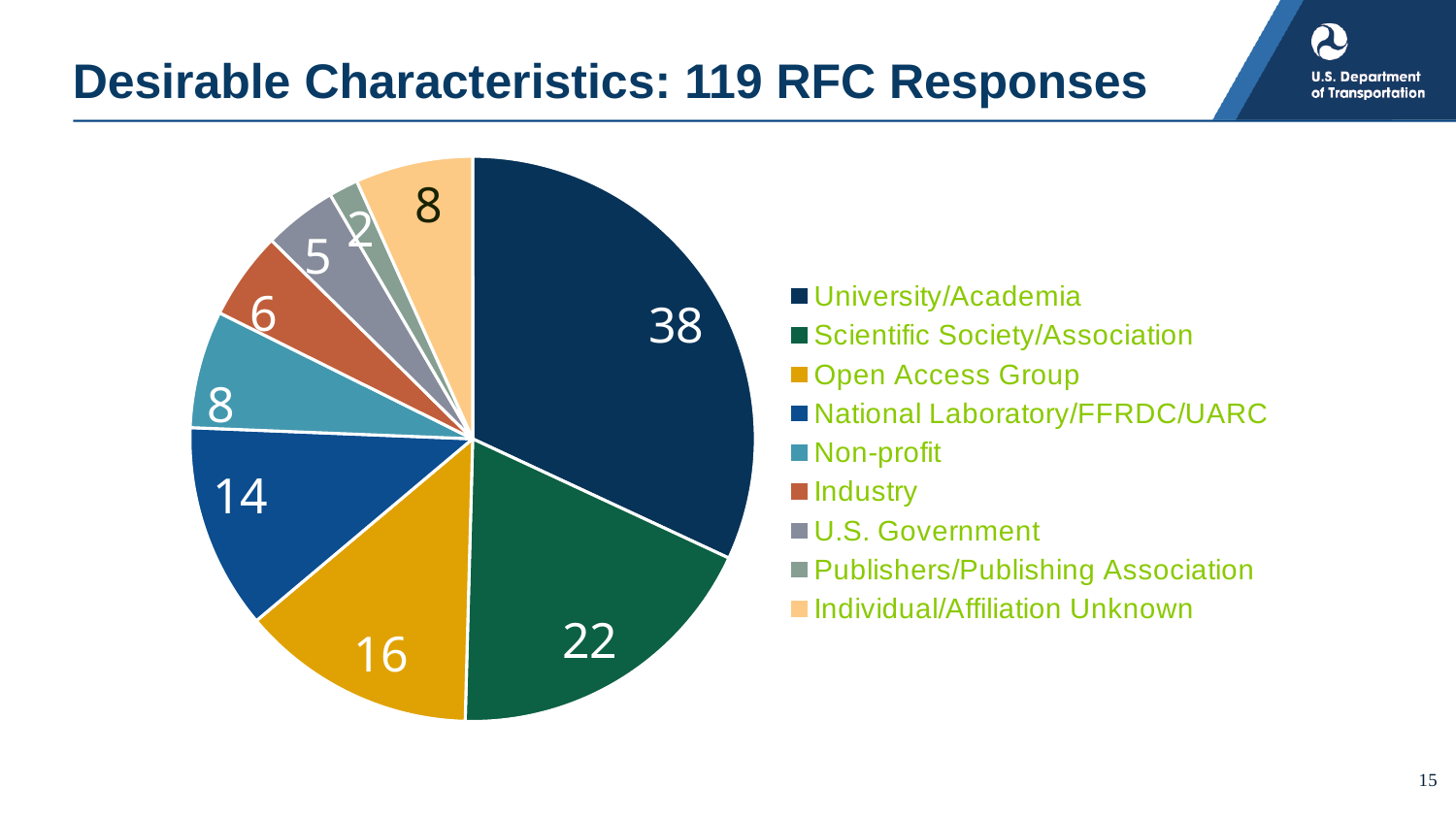
Which is larger, Open Access Group or National Laboratory/FFRDC/UARC? Open Access Group What type of chart is shown on the slide? Pie chart What is the title of the slide containing the chart? Desirable Characteristics: 119 RFC Responses What is the total of all the slices in the pie chart? 119 How many responses came from University/Academia? 38 What is the value for the Scientific Society/Association slice? 22 What is the difference between the University/Academia and Scientific Society/Association values? 16 Which category has the smallest slice of the pie? Publishers/Publishing Association What is the value for the Industry slice? 6 How many responses are attributed to National Laboratory/FFRDC/UARC? 14 How many categories does the legend list? 9 Which category has the largest slice of the pie? University/Academia